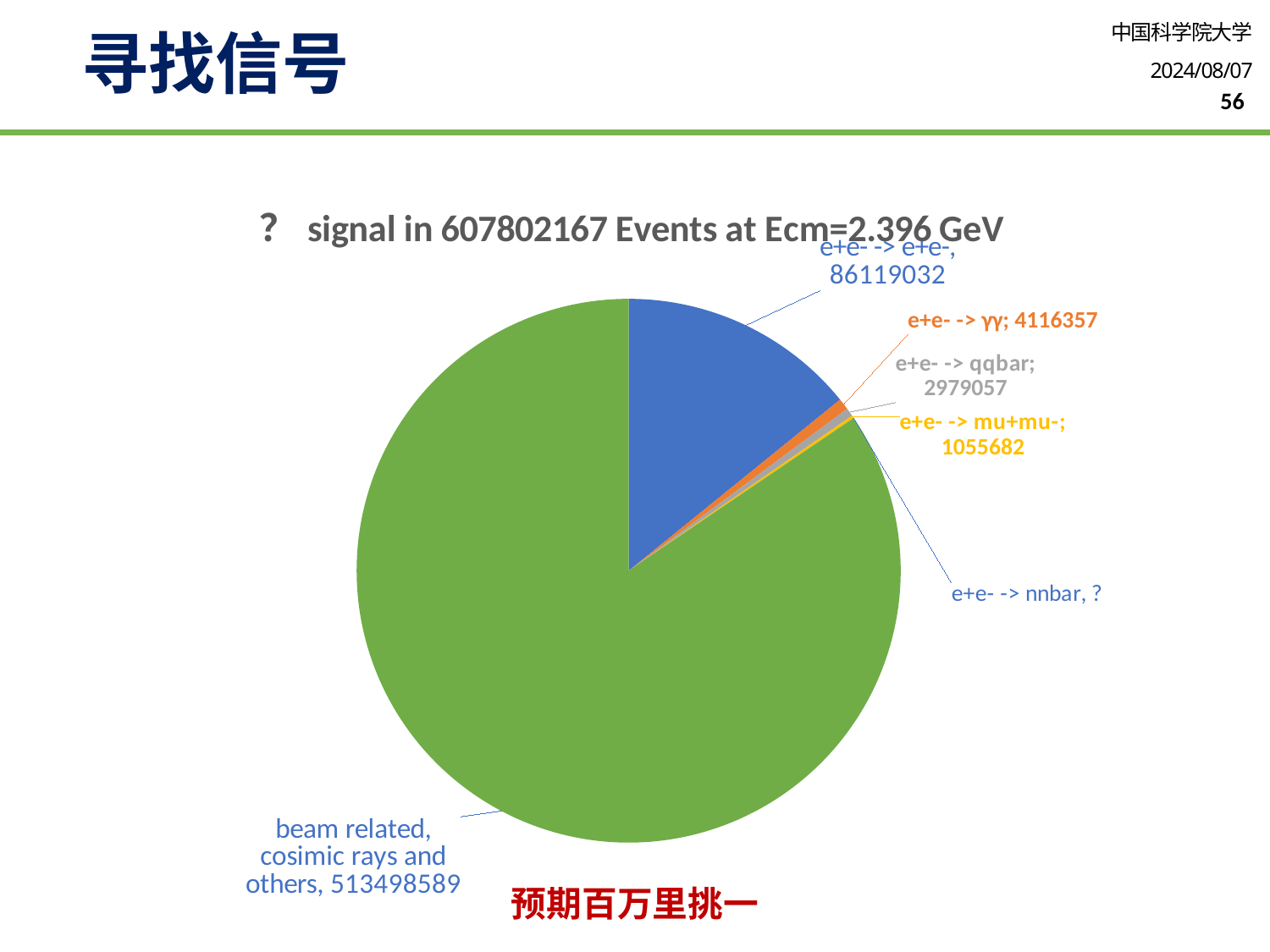
What kind of chart is shown on the slide? pie chart What is the difference between the 'e+e- -> qqbar' value and the 'e+e- -> mu+mu-' value? 1923375 What is the value for the 'e+e- -> mu+mu-' slice? 1055682 What colour is the largest slice of the pie chart? green What is the value for the 'e+e- -> e+e-' slice? 86119032 How many slices (categories) are labelled on the pie chart? 6 Which is larger, the 'e+e- -> e+e-' slice or the 'e+e- -> γγ' slice? e+e- -> e+e- What is the value for the 'e+e- -> qqbar' slice? 2979057 What is the value for the 'e+e- -> γγ' slice? 4116357 What is the value for the 'beam related, cosimic rays and others' slice? 513498589 Which slice of the pie is the largest? beam related, cosimic rays and others What is the difference between the 'e+e- -> e+e-' value and the 'e+e- -> γγ' value? 82002675